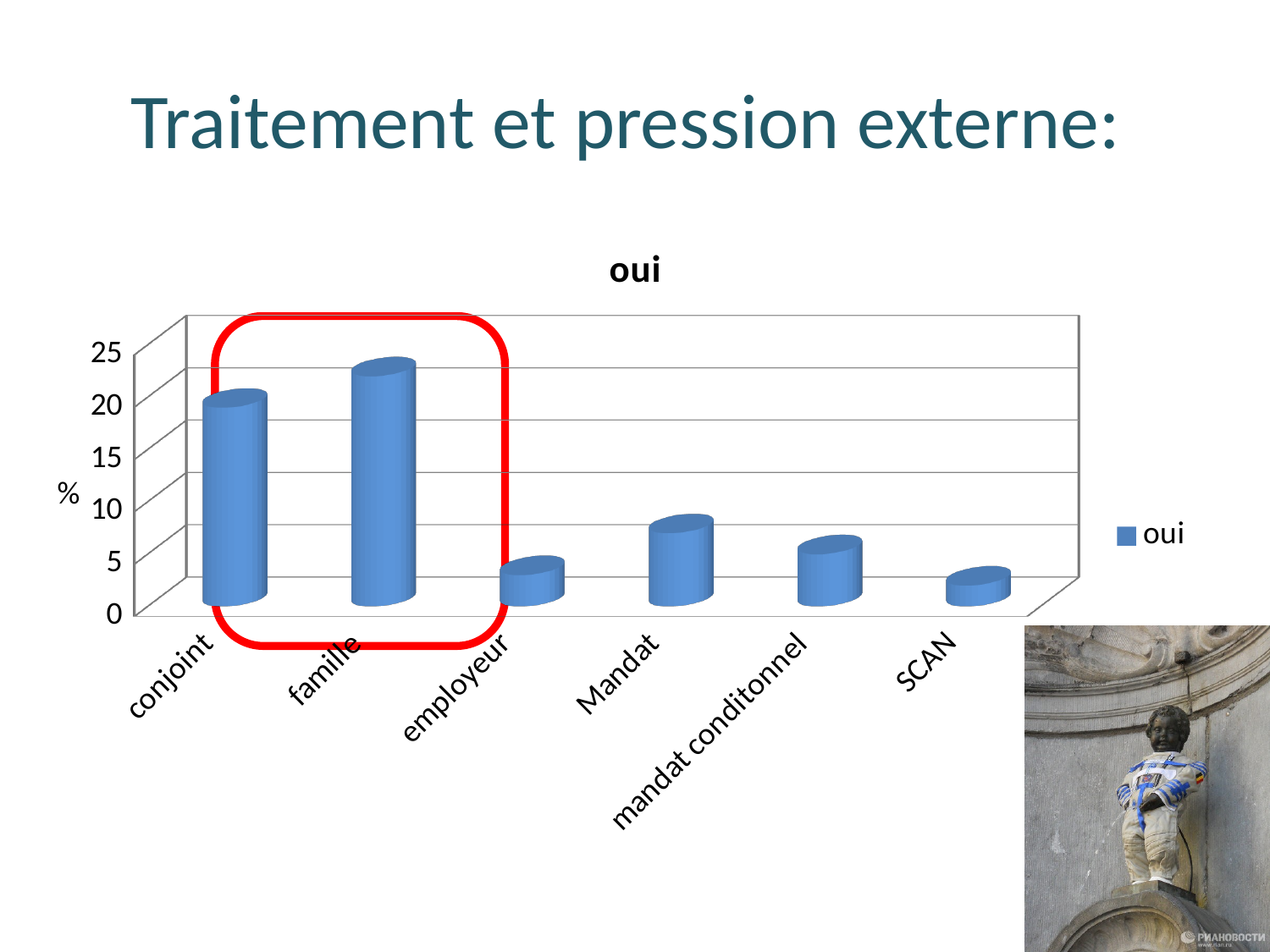
Which is larger, the value for famille or the value for conjoint? famille Is the value for conjoint greater or less than 15? greater Which category has the highest value in the chart? famille Is the value for employeur greater or less than 5? less Which is larger, the value for Mandat or the value for employeur? Mandat How many categories are shown on the x axis of the chart? 6 How many series does the chart's legend list? 1 Is the value for famille greater or less than 20? greater What is the title of the chart? oui What kind of chart is shown on the slide? bar chart